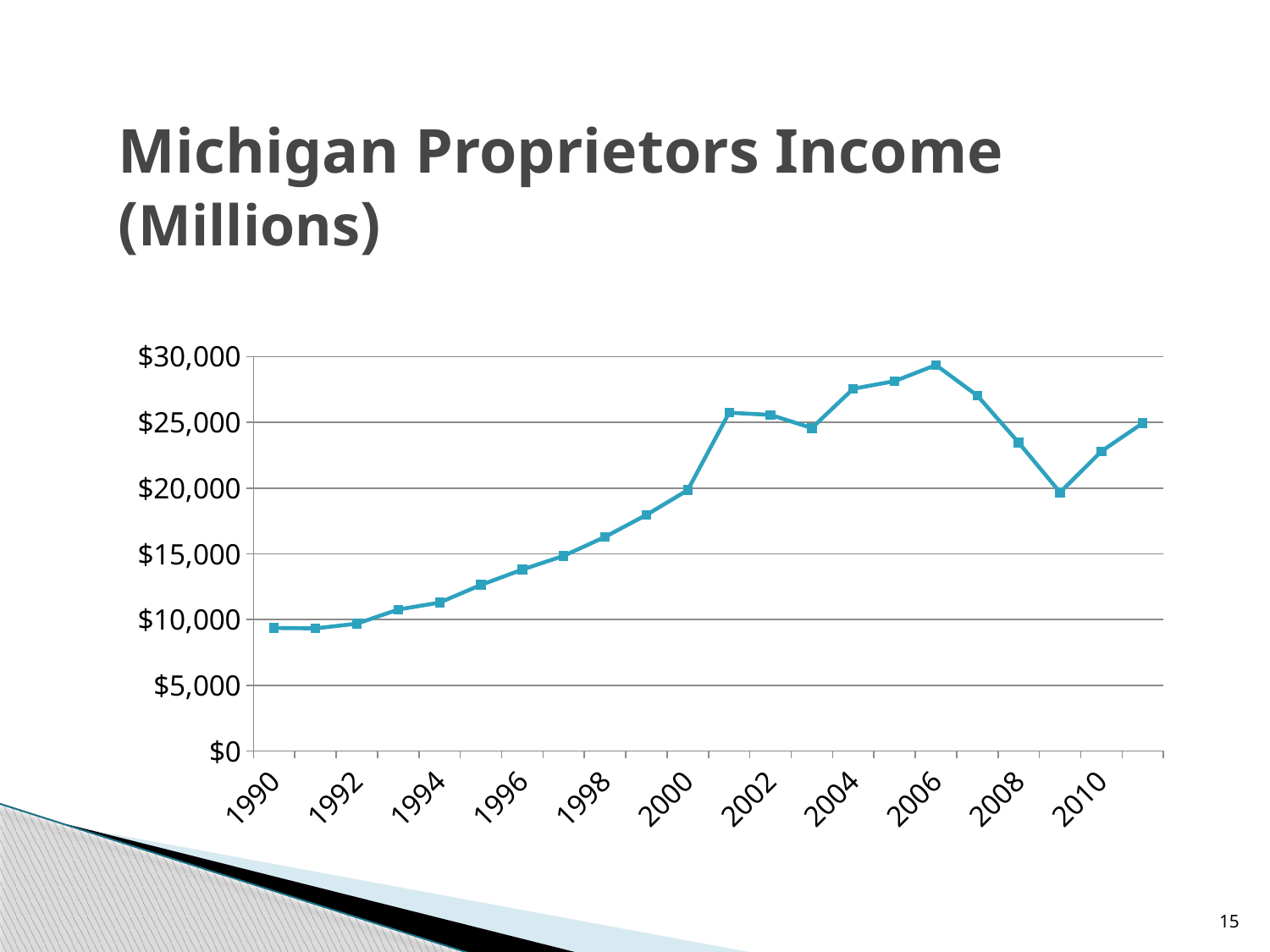
Is the value for 1990 greater or less than $10,000? less Is the value for 2010 greater or less than $20,000? greater Is the value for 1998 greater or less than $15,000? greater Does Michigan proprietors income rise or fall from 1990 to 2000? rise Which year has the larger value, 1990 or 2000? 2000 In which year does Michigan proprietors income reach its highest value? 2006 What is the title of the slide's chart? Michigan Proprietors Income (Millions) What kind of chart is shown on the slide? line chart Which year has the larger value, 2006 or 2009? 2006